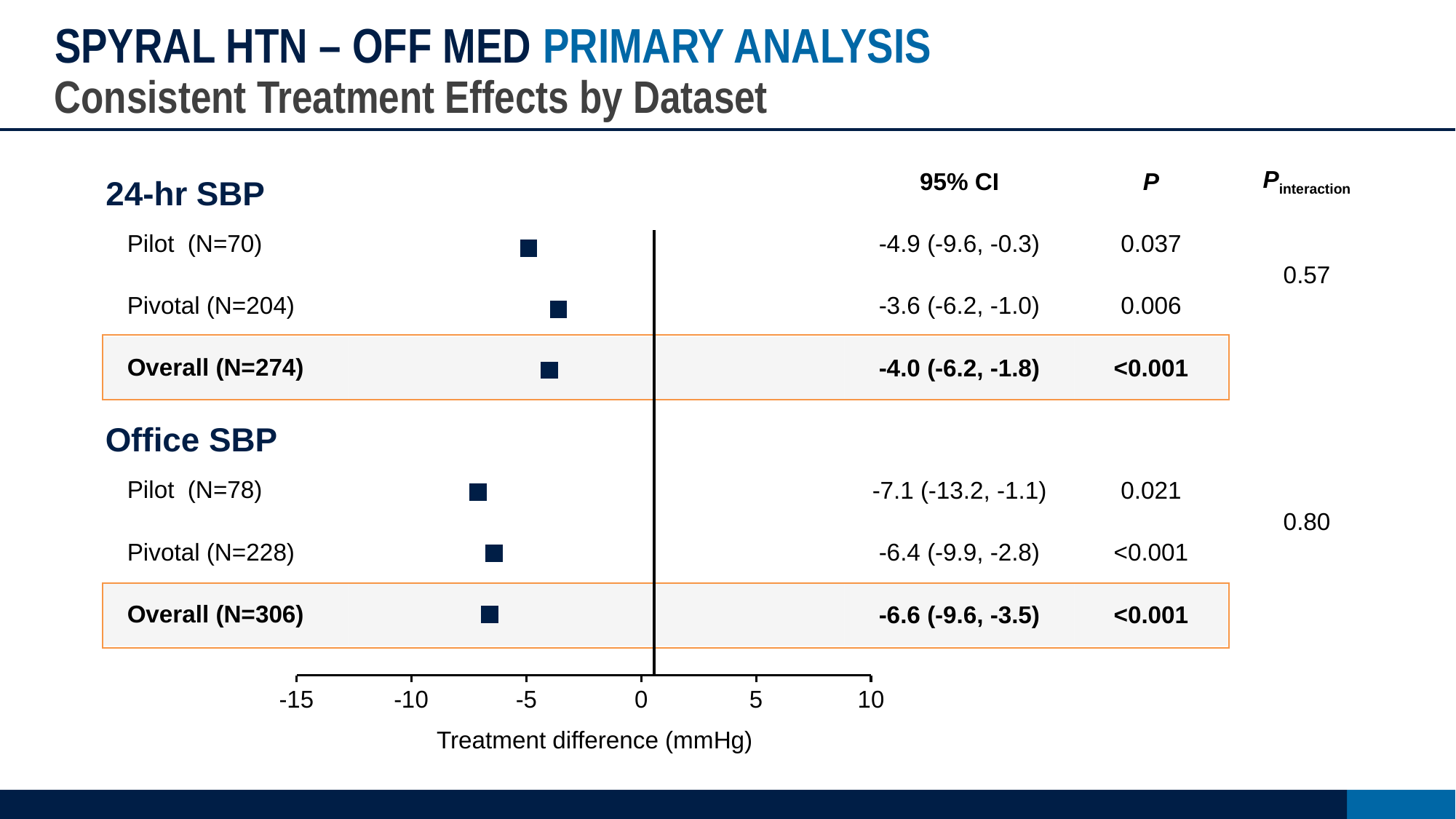
Which shows a larger reduction in SBP: the 24-hr SBP Pilot or the Office SBP Pilot? Office SBP Pilot What is the 95% CI for the 24-hr SBP Pivotal (N=204) dataset? (-6.2, -1.0) What is the P interaction value for the Office SBP datasets? 0.80 Is the treatment difference for the Office SBP Pivotal (N=228) dataset greater or less than -5? less What is the treatment difference for the 24-hr SBP Pilot (N=70) dataset? -4.9 Which dataset has the most negative (largest reduction) treatment difference? Office SBP Pilot (N=78) What is the difference between the Office SBP Overall treatment difference and the 24-hr SBP Overall treatment difference? 2.6 mmHg What is the P value for the Office SBP Pilot (N=78) dataset? 0.021 How many datasets (points) are plotted in the chart? 6 Which dataset has the treatment difference closest to zero? 24-hr SBP Pivotal (N=204) What kind of chart is shown on the slide? Forest plot What is the treatment difference for the Office SBP Overall (N=306) dataset? -6.6